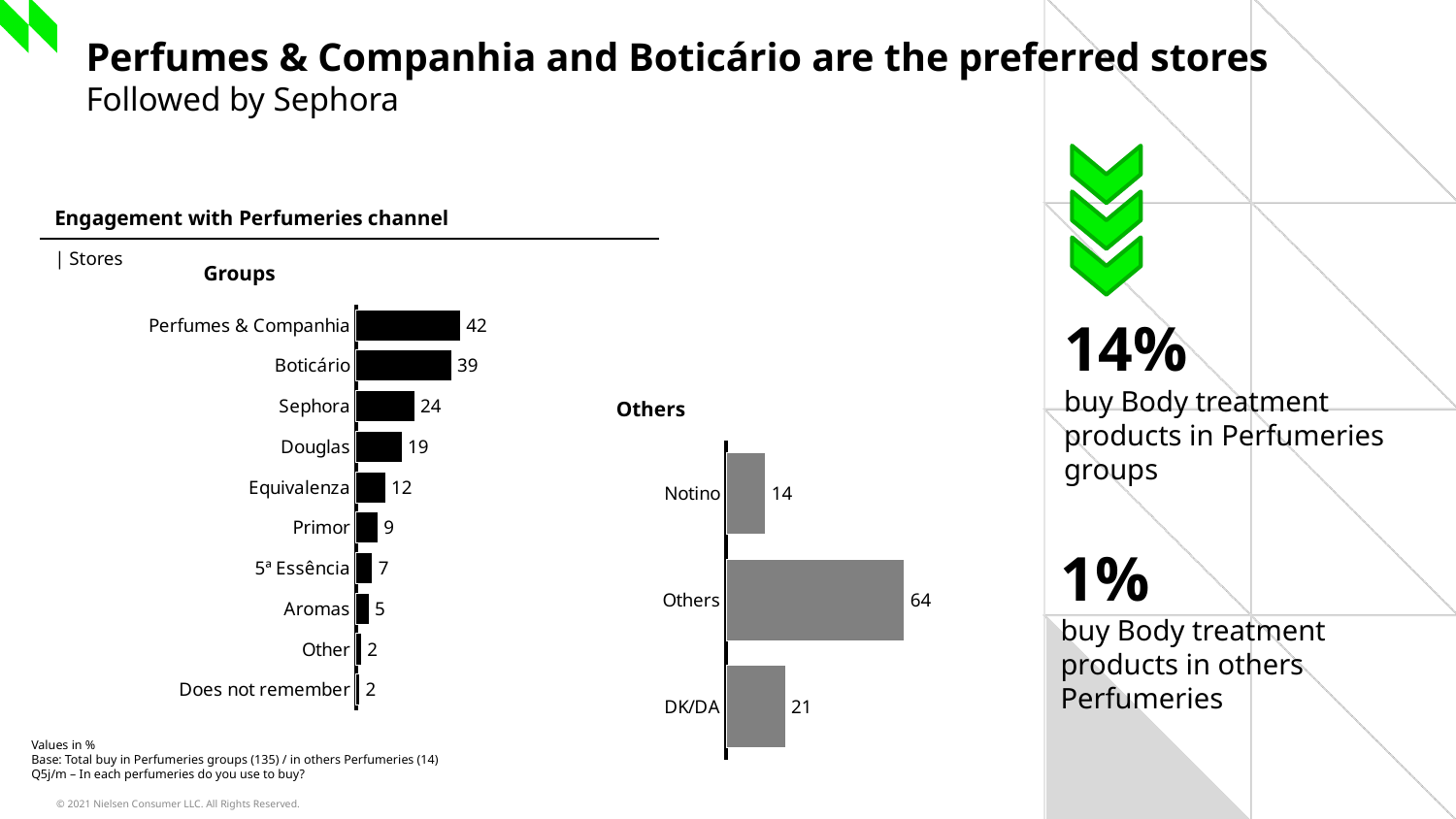
In the Groups chart, which is larger, Douglas or Primor? Douglas In the Groups chart, how many categories are shown? 10 What kind of chart is the Groups chart? Bar chart In the Groups chart, what is the value for Aromas? 5 In the Others chart, what is the difference between Others and DK/DA? 43 In the Groups chart, what is the value for Equivalenza? 12 In the Groups chart, which store has the highest value? Perfumes & Companhia In the Others chart, which category has the highest value? Others In the Others chart, what is the value for Notino? 14 In the Groups chart, what is the difference between Perfumes & Companhia and Boticário? 3 In the Others chart, which category has the lowest value? Notino In the Groups chart, what is the value for Sephora? 24